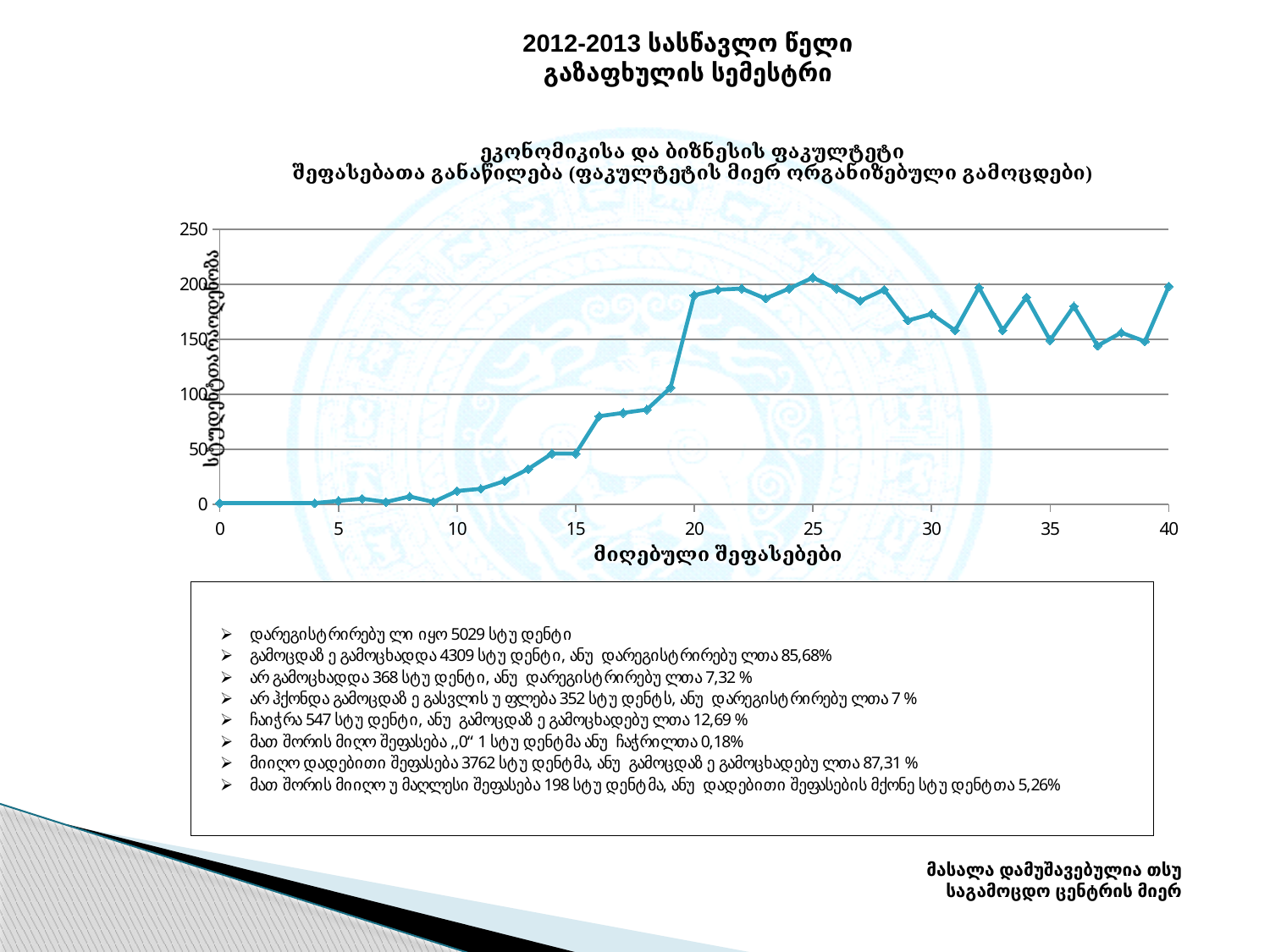
Is the value for score 10 greater or less than 50? less Is the value for score 40 greater or less than 150? greater Do the values rise or fall along the x axis between score 0 and score 20? rise What kind of chart is shown on the slide? line chart Is the value for score 5 greater or less than 50? less Which is larger, the value for score 20 or the value for score 10? score 20 What is the highest tick value shown on the y axis? 250 What is the label of the x axis? მიღებული შეფასებები